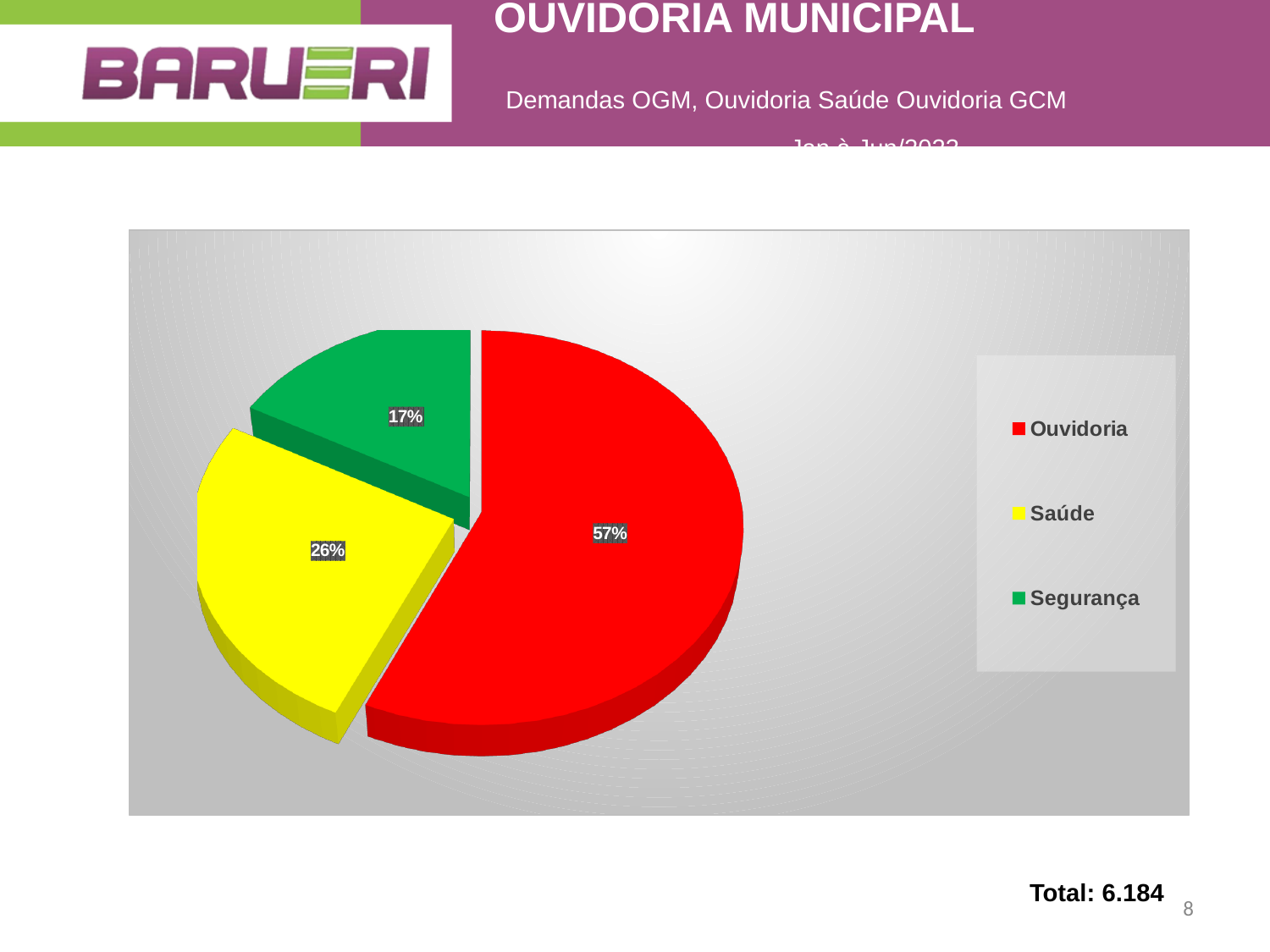
What share of the pie does Saúde represent? 26% How many categories does the pie chart show? 3 Which category has the largest slice of the pie? Ouvidoria What share of the pie does Ouvidoria represent? 57% What total is printed below the chart? 6.184 What is the difference in percentage points between the Ouvidoria and Saúde slices? 31 What colour is the Saúde slice in the pie chart? yellow What kind of chart is shown on the slide? pie chart Which slice is larger, Saúde or Segurança? Saúde What is the difference in percentage points between the Saúde and Segurança slices? 9 What share of the pie does Segurança represent? 17% Which category has the smallest slice of the pie? Segurança